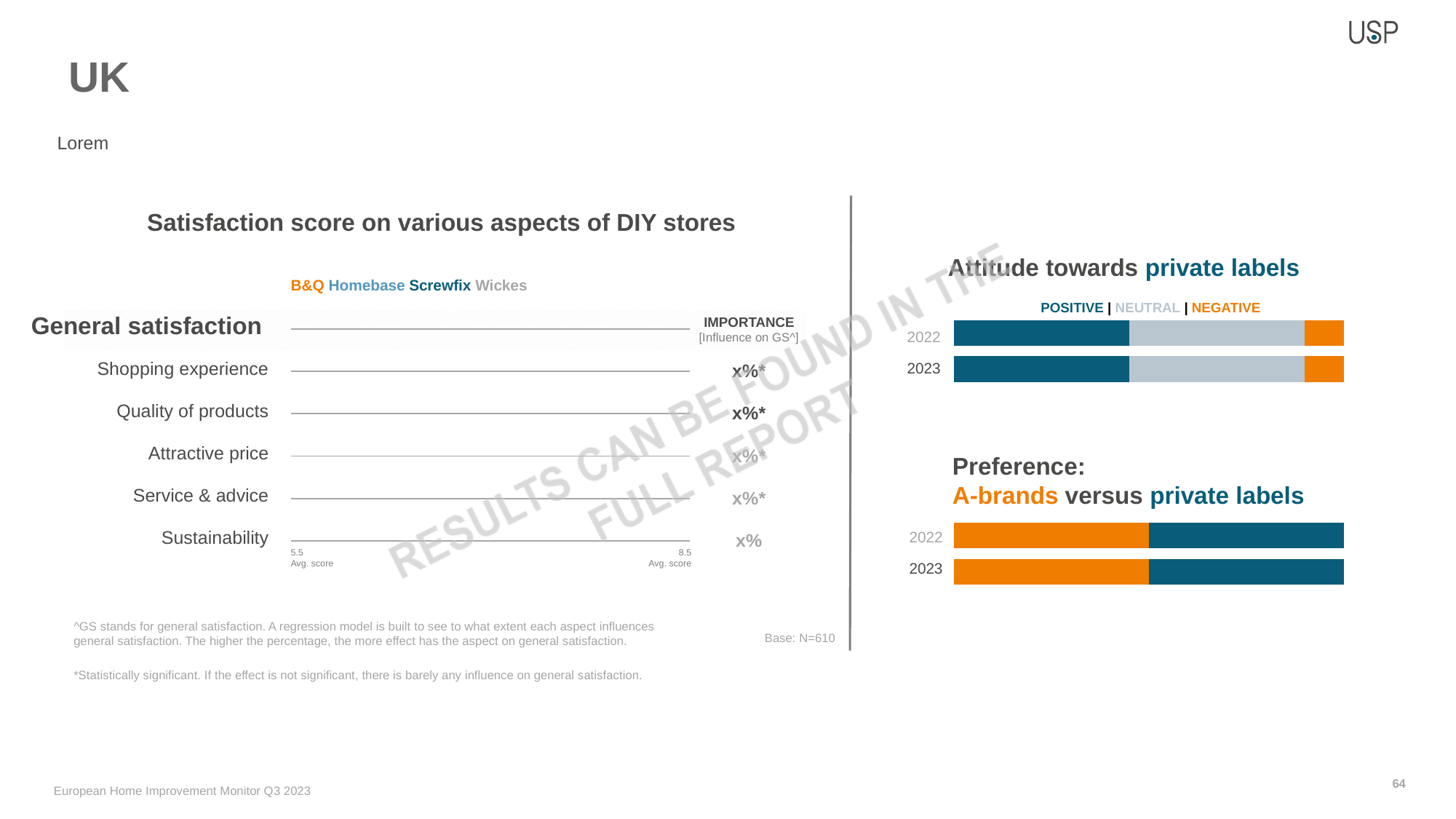
What kind of chart is the 'Preference: A-brands versus private labels' chart? Stacked bar chart In the 'Attitude towards private labels' chart, how many years are shown? 2 In the 'Satisfaction score on various aspects of DIY stores' chart, what are the two end values of the average score axis? 5.5 and 8.5 In the 'Attitude towards private labels' chart, for 2023, which segment is larger: positive or negative? Positive In the 'Satisfaction score on various aspects of DIY stores' chart, how many aspect rows are listed, including General satisfaction? 6 What kind of chart is the 'Attitude towards private labels' chart? Stacked bar chart In the 'Attitude towards private labels' chart, for 2022, which segment is larger: neutral or negative? Neutral In the 'Preference: A-brands versus private labels' chart, which years are shown? 2022 and 2023 In the 'Attitude towards private labels' chart, how many series does the legend list? 3 In the 'Satisfaction score on various aspects of DIY stores' chart, how many stores does the legend list? 4 In the 'Satisfaction score on various aspects of DIY stores' chart, which stores are listed in the legend? B&Q, Homebase, Screwfix, Wickes In the 'Preference: A-brands versus private labels' chart, how many series are shown? 2